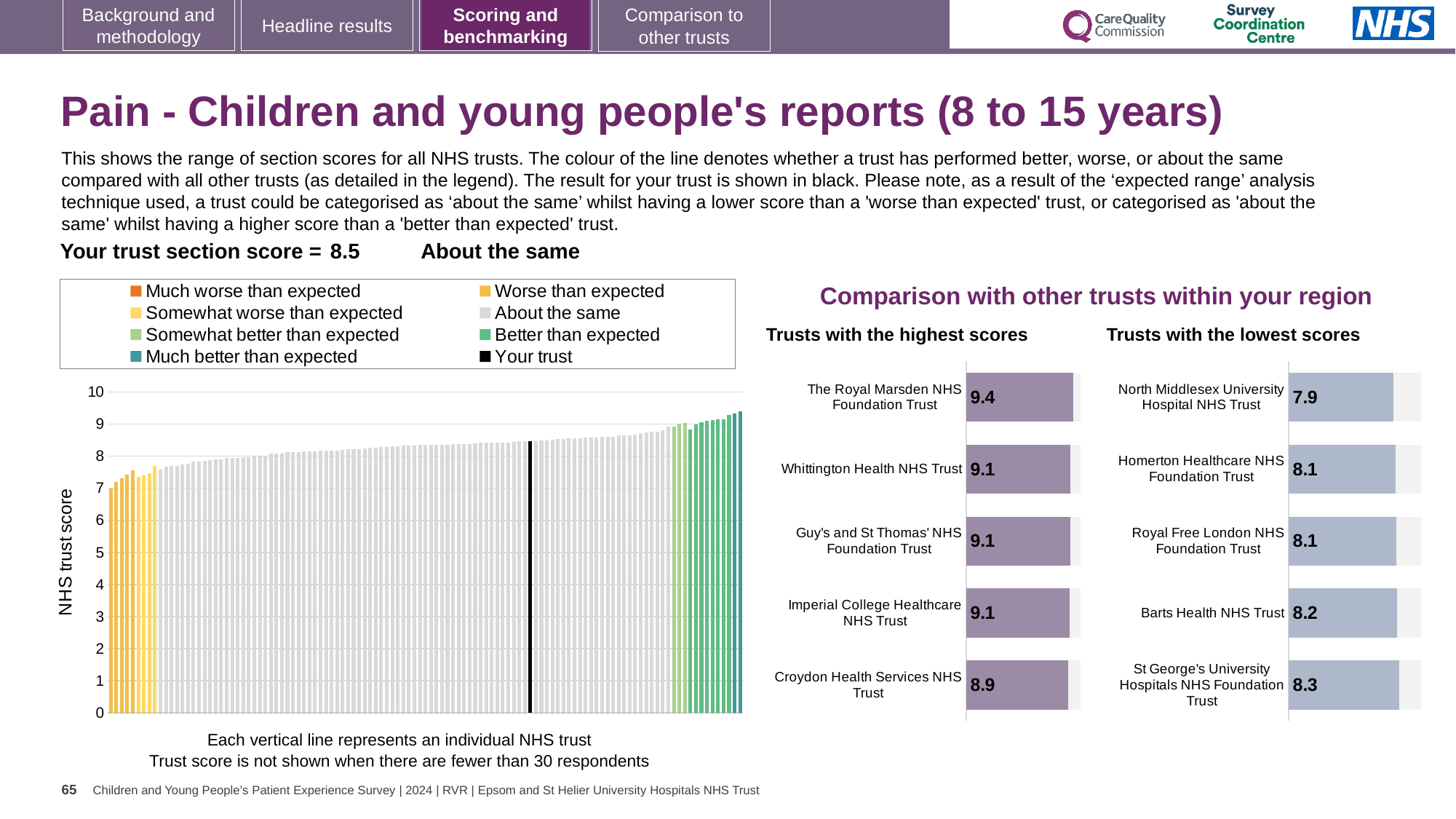
What kind of chart is the large chart on the left showing all NHS trusts? Bar chart In the large chart on the left, do the bar values rise or fall from left to right along the x axis? Rise In the 'Trusts with the highest scores' chart, what is the difference between the scores of The Royal Marsden NHS Foundation Trust and Croydon Health Services NHS Trust? 0.5 How many entries does the legend of the large chart on the left list? 8 In the 'Trusts with the lowest scores' chart, what is the score for North Middlesex University Hospital NHS Trust? 7.9 In the 'Trusts with the lowest scores' chart, which trust has the highest score? St George's University Hospitals NHS Foundation Trust In the 'Trusts with the highest scores' chart, how many trusts are shown? 5 In the 'Trusts with the highest scores' chart, what is the score for The Royal Marsden NHS Foundation Trust? 9.4 In the 'Trusts with the lowest scores' chart, what is the difference between the scores of St George's University Hospitals NHS Foundation Trust and North Middlesex University Hospital NHS Trust? 0.4 In the 'Trusts with the highest scores' chart, which trust has the lowest score? Croydon Health Services NHS Trust In the large chart on the left, what is the section score for your trust (the black bar)? 8.5 In the 'Trusts with the lowest scores' chart, which has the larger score: Barts Health NHS Trust or Homerton Healthcare NHS Foundation Trust? Barts Health NHS Trust